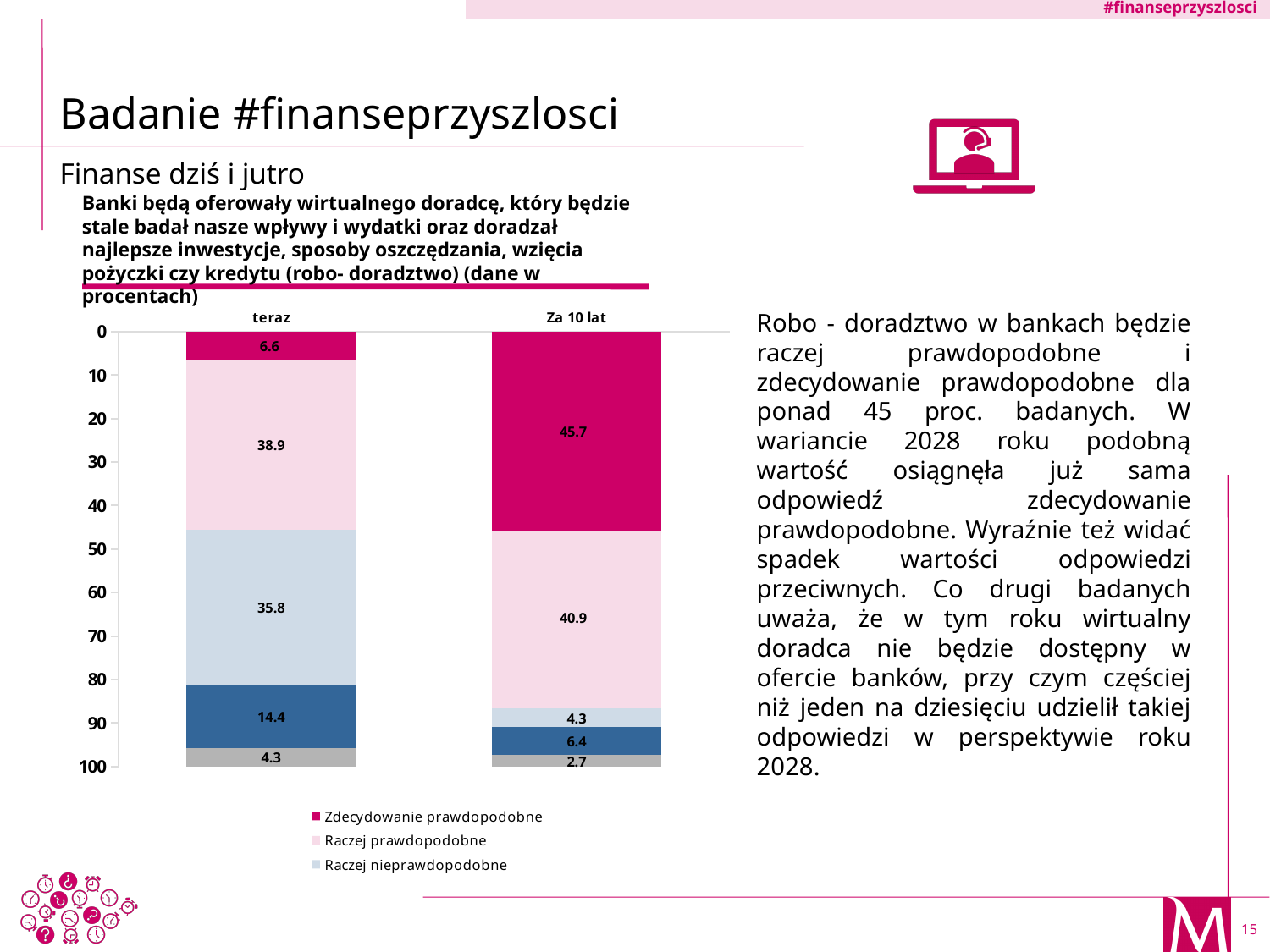
How many categories are shown on the x axis of the chart? 2 What is the difference between Raczej nieprawdopodobne for teraz and for Za 10 lat? 31.5 How many series does the chart legend list? 3 What is the value of Zdecydowanie prawdopodobne for Za 10 lat? 45.7 Which legend series has the largest value in the Za 10 lat bar? Zdecydowanie prawdopodobne What is the value of Zdecydowanie prawdopodobne for teraz? 6.6 What is the value of Raczej prawdopodobne for teraz? 38.9 By how much does Zdecydowanie prawdopodobne for Za 10 lat exceed Zdecydowanie prawdopodobne for teraz? 39.1 Is Raczej prawdopodobne larger for teraz or for Za 10 lat? Za 10 lat What is the value of Raczej prawdopodobne for Za 10 lat? 40.9 What is the value of Raczej nieprawdopodobne for Za 10 lat? 4.3 What is the value of Raczej nieprawdopodobne for teraz? 35.8